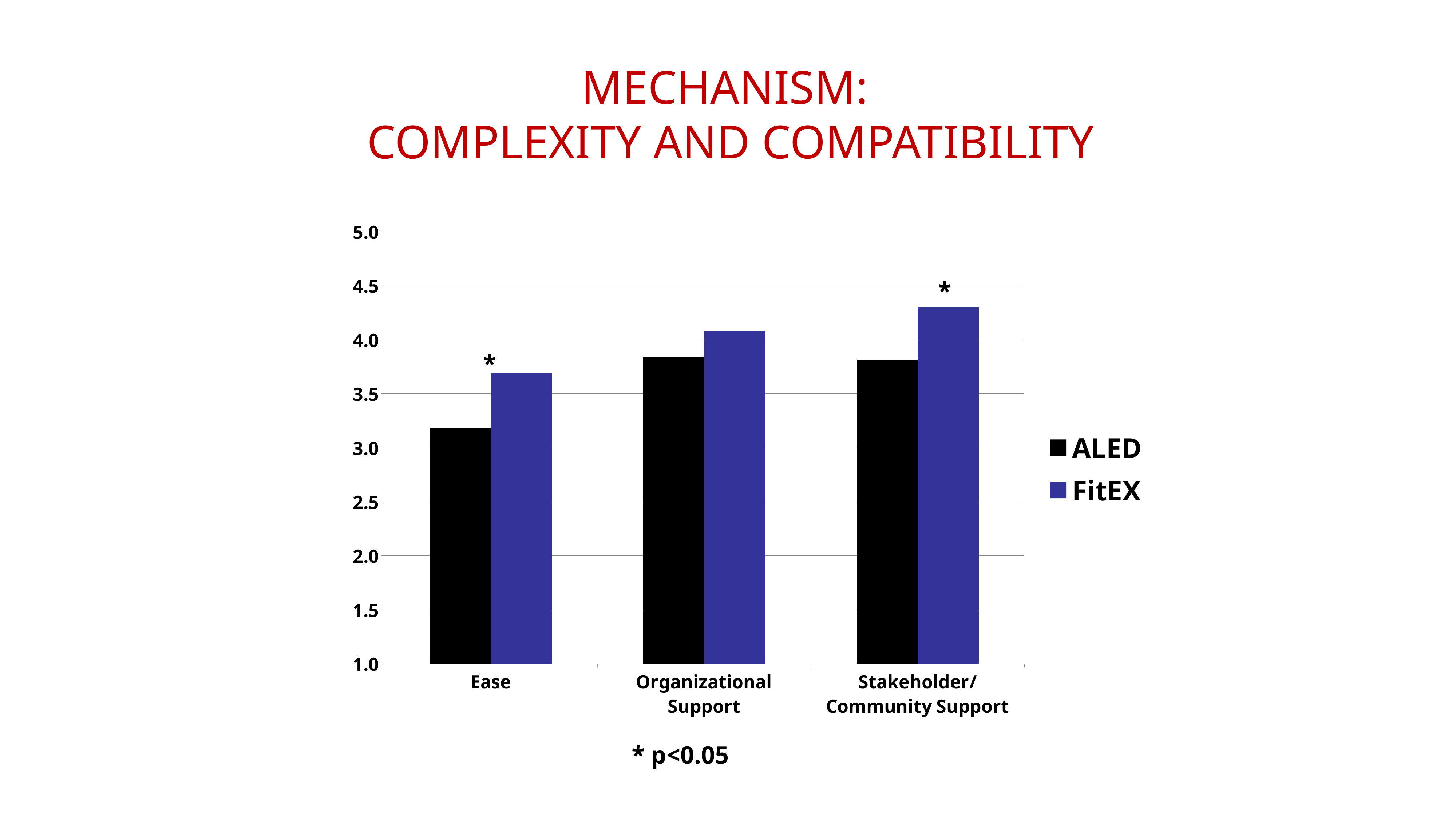
Which series and category has the lowest bar in the chart? ALED, Ease Is the FitEX value for Stakeholder/Community Support greater or less than 4.0? greater Which series and category has the highest bar in the chart? FitEX, Stakeholder/Community Support For the Stakeholder/Community Support category, which series has the larger value, ALED or FitEX? FitEX What are the two series names listed in the chart's legend? ALED and FitEX Is the ALED value for Ease greater or less than 3.5? less What kind of chart is shown on the slide? bar chart How many categories are shown on the x axis of the chart? 3 Is the ALED value for Organizational Support greater or less than 4.0? less For the Ease category, which series has the larger value, ALED or FitEX? FitEX How many series does the chart's legend list? 2